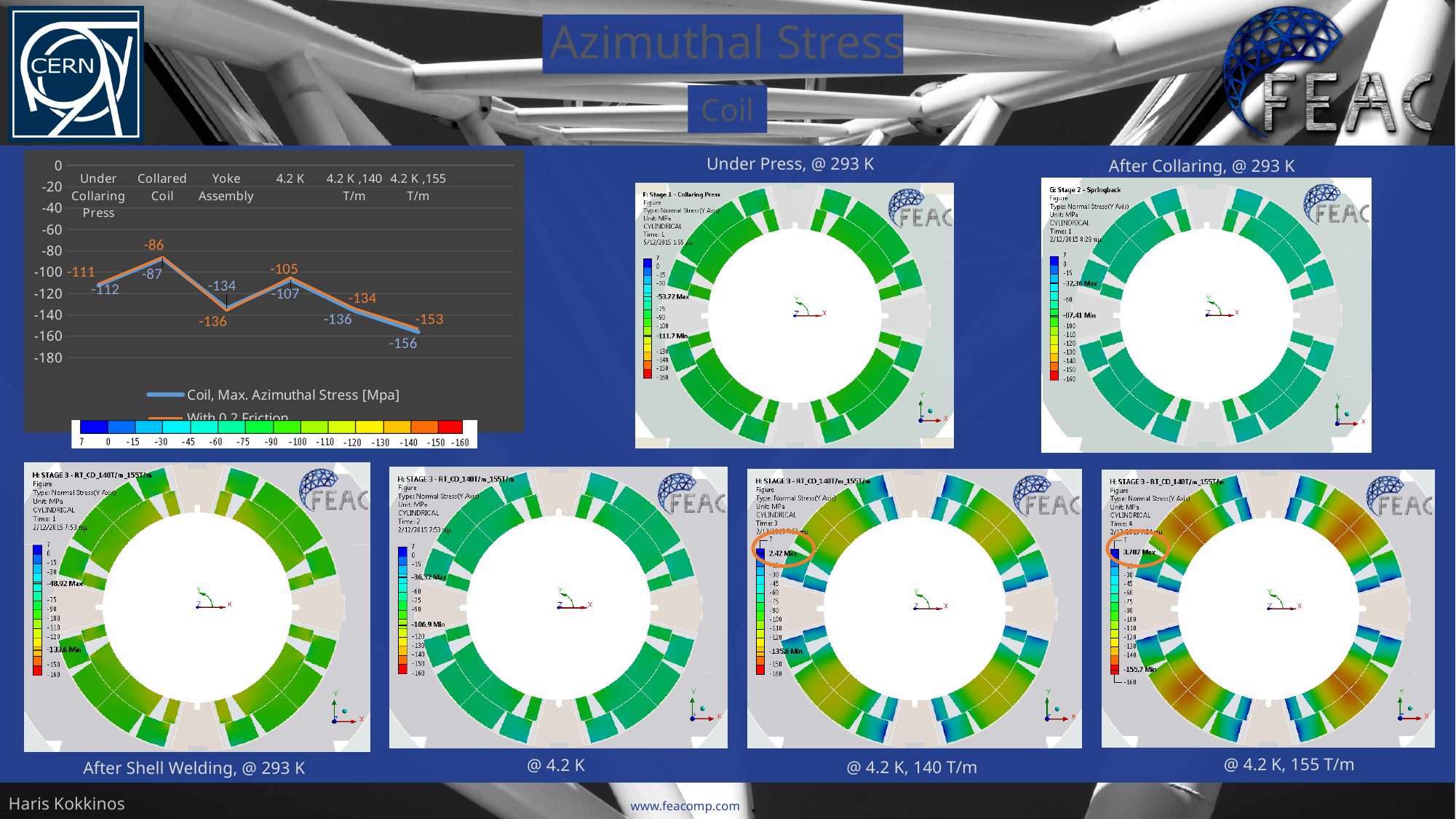
In the line chart, what is the With 0.2 Friction value for Collared Coil? -86 In the line chart, which is larger: the Coil, Max. Azimuthal Stress [Mpa] value at 4.2 K or at 4.2 K, 140 T/m? 4.2 K What kind of chart is shown on the left of the slide? line chart In the line chart, what is the Coil, Max. Azimuthal Stress [Mpa] value for Yoke Assembly? -134 In the line chart, which category has the lowest Coil, Max. Azimuthal Stress [Mpa] value? 4.2 K, 155 T/m In the line chart, what is the difference between the Coil, Max. Azimuthal Stress [Mpa] value and the With 0.2 Friction value at 4.2 K, 155 T/m? 3 How many categories are plotted along the x axis of the line chart? 6 In the line chart, what is the With 0.2 Friction value at 4.2 K, 155 T/m? -153 In the line chart, what is the difference between the Coil, Max. Azimuthal Stress [Mpa] values for Collared Coil and Yoke Assembly? 47 In the line chart, which category has the highest Coil, Max. Azimuthal Stress [Mpa] value? Collared Coil How many series does the legend of the line chart list? 2 In the line chart, what is the Coil, Max. Azimuthal Stress [Mpa] value for Under Collaring Press? -112